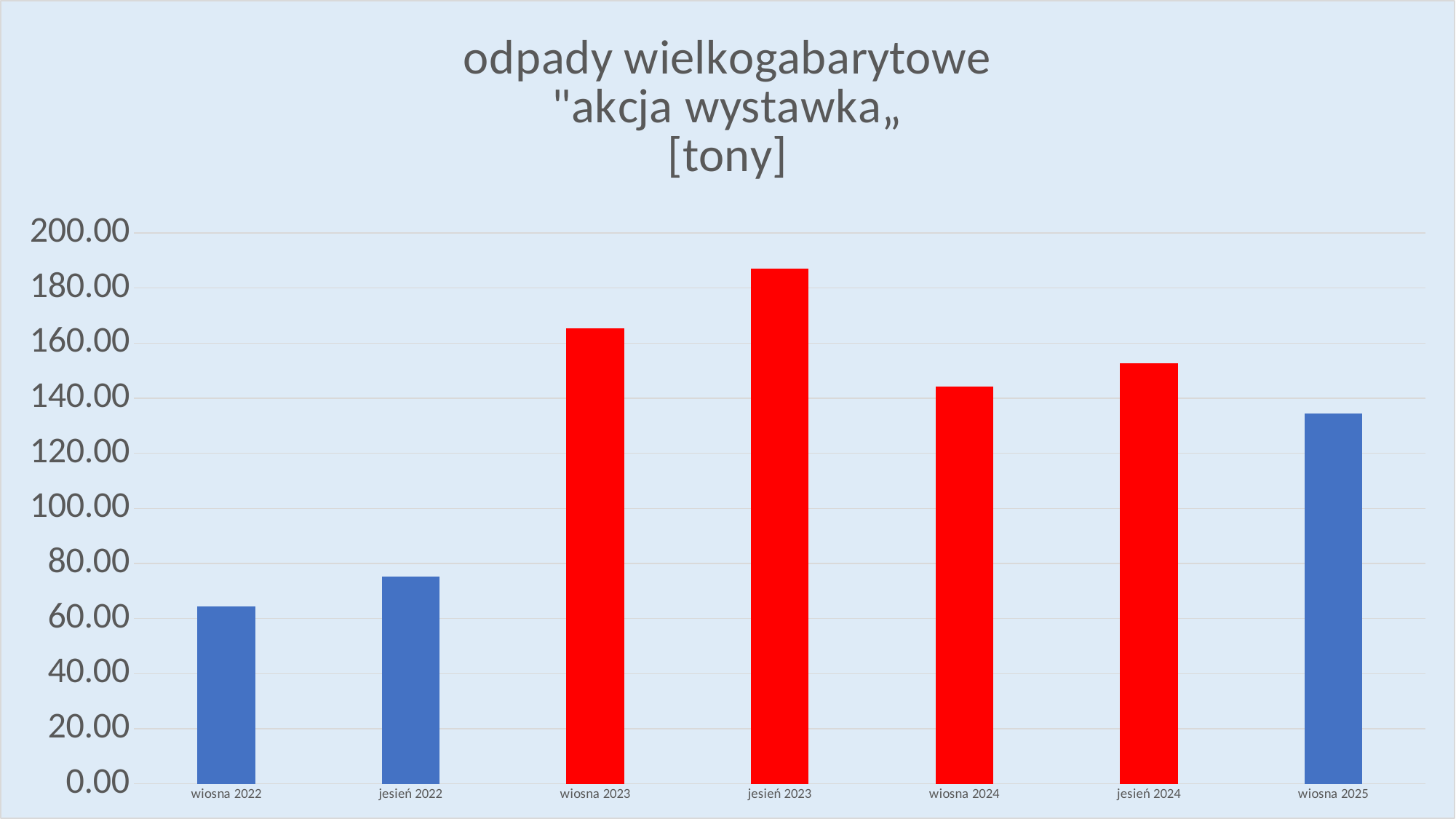
Which is larger, the value for jesień 2024 or the value for wiosna 2025? jesień 2024 What unit is given in the chart title? tony What kind of chart is shown on the slide? bar chart Which category has the highest value? jesień 2023 Which is larger, the value for wiosna 2023 or the value for wiosna 2024? wiosna 2023 Is the value for jesień 2023 greater or less than 180.00? greater Is the value for jesień 2022 greater or less than 80.00? less How many categories are shown on the x axis? 7 Which category has the lowest value? wiosna 2022 Do the values rise or fall from wiosna 2022 to jesień 2023? rise Is the value for wiosna 2022 greater or less than 80.00? less